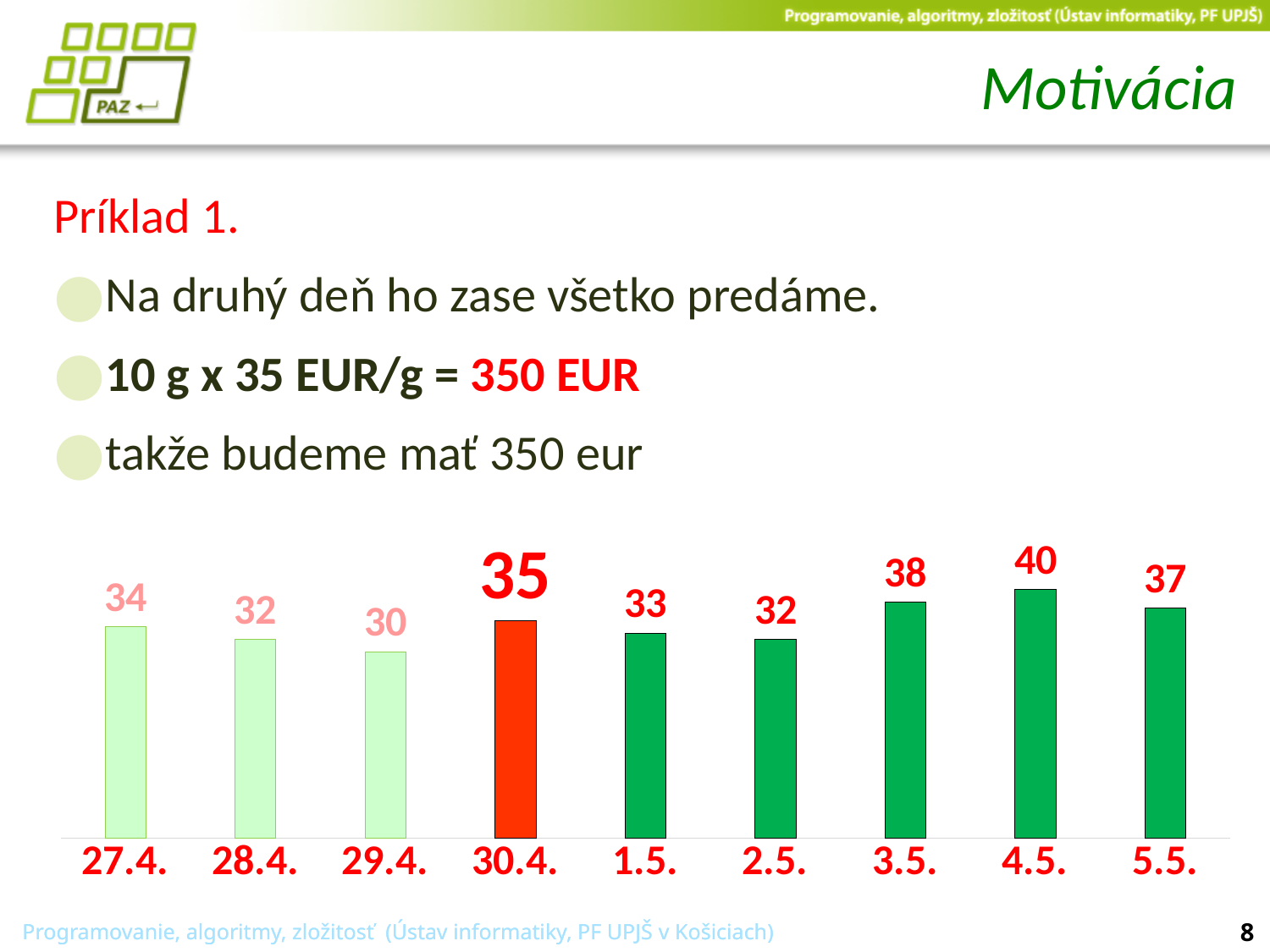
What is the value for 4.5.? 40 What is the difference between the values for 4.5. and 30.4.? 5 What kind of chart is shown on the slide? bar chart How many dates are shown on the x axis? 9 What is the difference between the values for 27.4. and 29.4.? 4 Do the values rise or fall from 30.4. to 2.5.? fall Which date has the highest value? 4.5. What is the value for 29.4.? 30 Which bar is coloured red? 30.4. Which is larger, the value for 3.5. or the value for 5.5.? 3.5. What is the value for 30.4.? 35 Which date has the lowest value? 29.4.